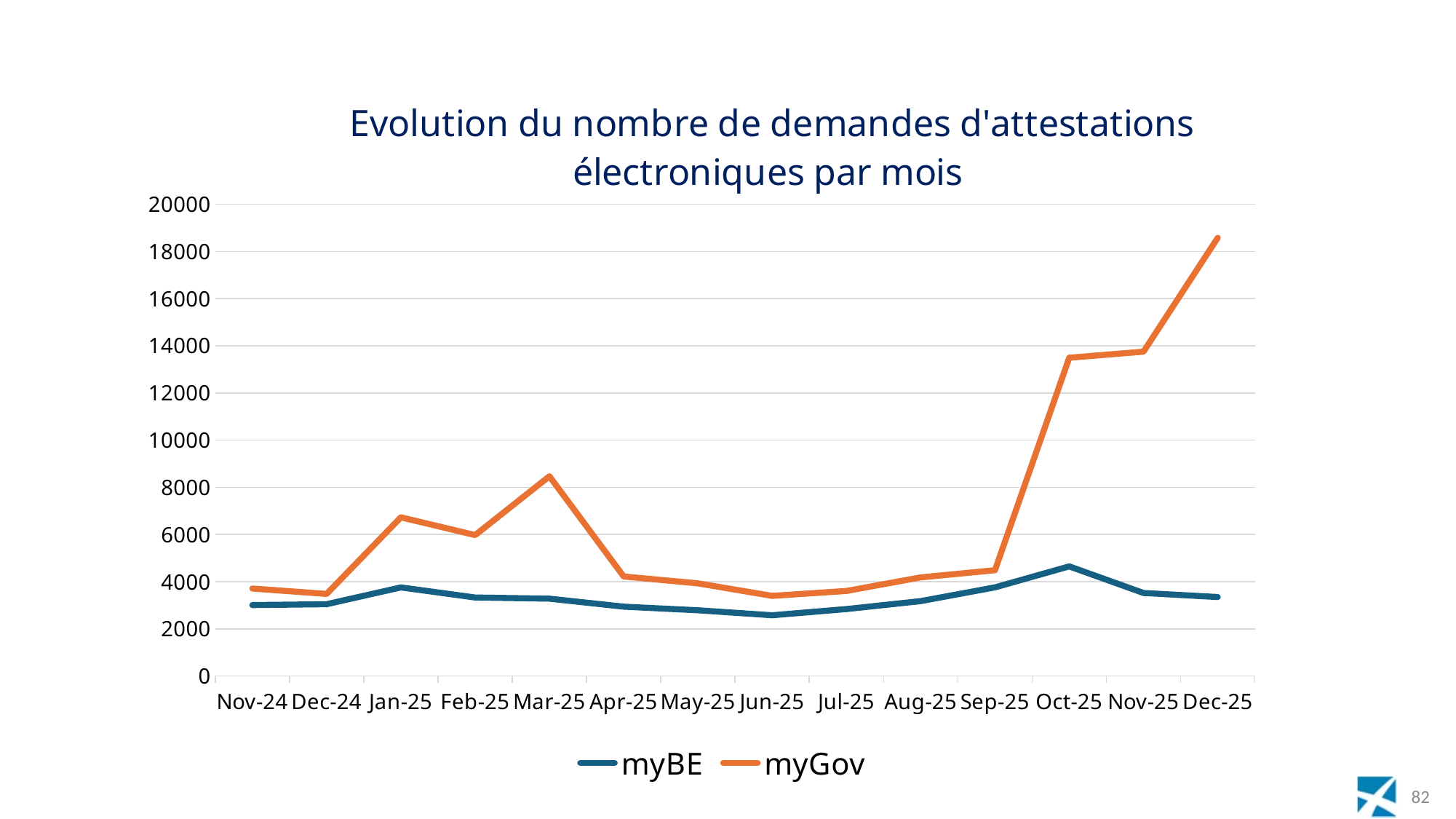
Is the value for myGov in Mar-25 greater or less than 10000? less How many months are plotted along the x axis? 14 What kind of chart is shown on the slide? line chart In which month does the myBE series reach its highest value? Oct-25 Is the value for myGov in Dec-25 greater or less than 16000? greater What is the title of the chart? Evolution du nombre de demandes d'attestations électroniques par mois Is the value for myBE in Oct-25 greater or less than 4000? greater In which month does the myBE series reach its lowest value? Jun-25 In Oct-25, which series has the larger value, myBE or myGov? myGov How many series does the legend list? 2 In which month does the myGov series reach its highest value? Dec-25 Does the myGov series rise or fall from Sep-25 to Dec-25? rise